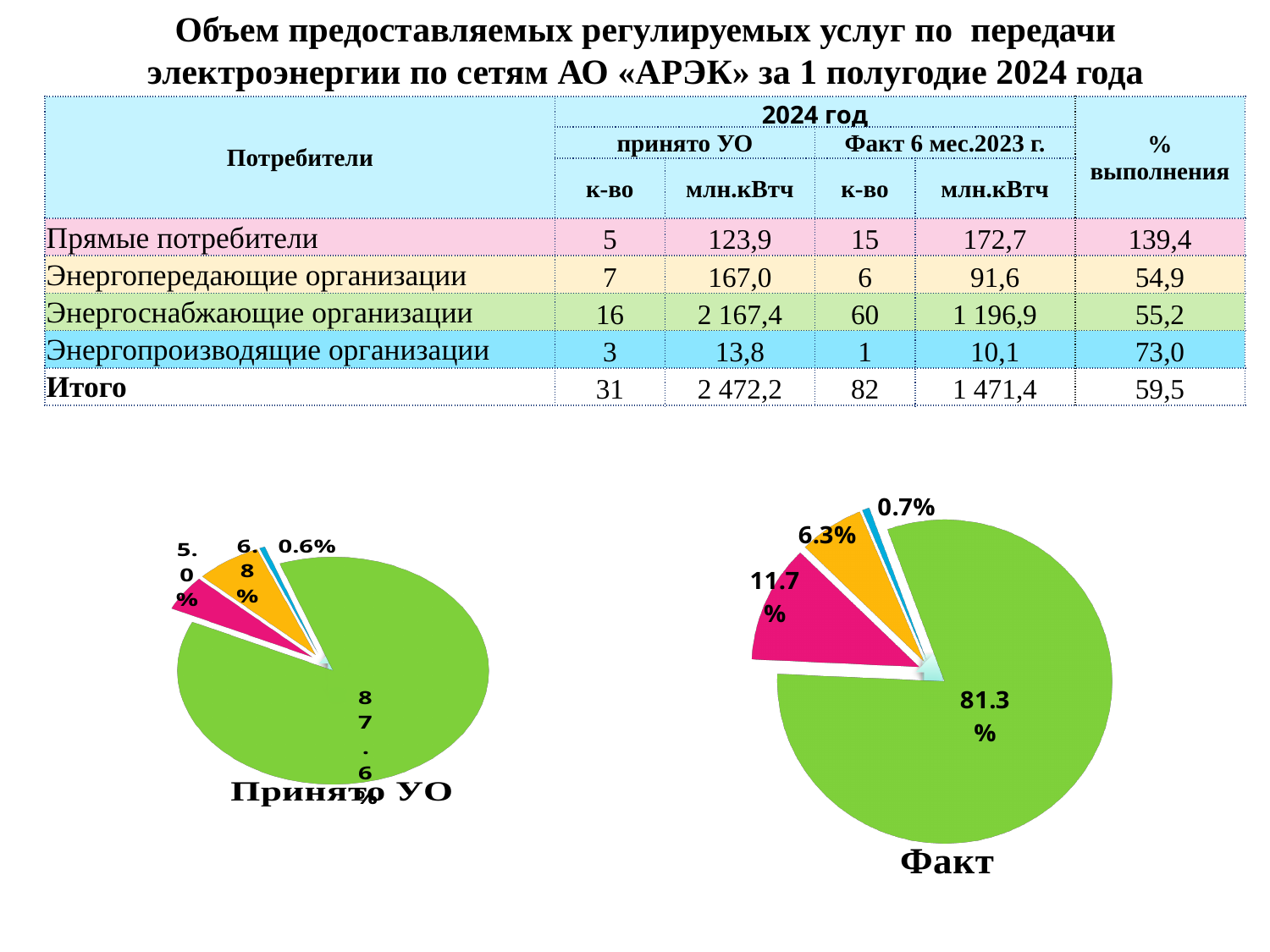
In the "Принято УО" pie chart, what is the share of the smallest slice? 0.6% What is the difference between the green slice shares in the "Принято УО" chart (87.6%) and the "Факт" chart (81.3%)? 6.3% In the "Факт" pie chart, what is the share of the yellow slice? 6.3% What is the title of the pie chart on the right side of the slide? Факт In the "Факт" pie chart, what is the share of the pink slice? 11.7% Which is larger: the pink slice in the "Принято УО" chart or the pink slice in the "Факт" chart? the pink slice in the "Факт" chart In the "Принято УО" pie chart, what is the share of the largest (green) slice? 87.6% What kind of chart is the "Факт" chart? pie chart In the "Факт" pie chart, what is the share of the largest (green) slice? 81.3% In the "Факт" pie chart, what is the share of the smallest slice? 0.7% How many slices does the "Принято УО" pie chart have? 4 What kind of chart is the "Принято УО" chart? pie chart